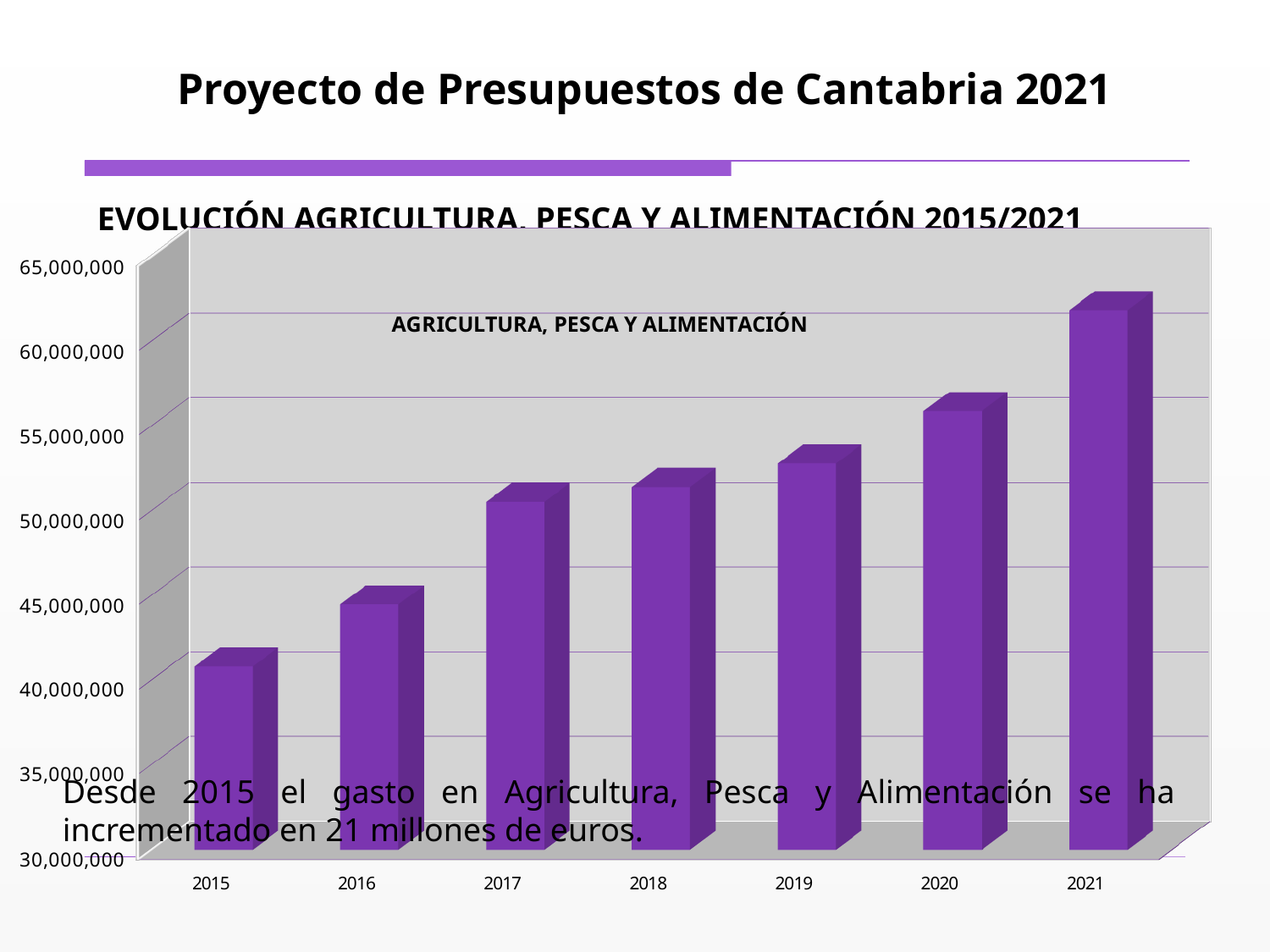
Is the value for 2019 greater or less than 50,000,000? greater Which is larger, the value for 2015 or the value for 2021? 2021 Which is larger, the value for 2016 or the value for 2019? 2019 What is the title of the chart? AGRICULTURA, PESCA Y ALIMENTACIÓN Do the values rise or fall from 2015 to 2021? rise Is the value for 2015 greater or less than 45,000,000? less Which year has the lowest value on the chart? 2015 Is the value for 2021 greater or less than 60,000,000? greater Which year has the highest value on the chart? 2021 How many years are plotted on the chart? 7 What kind of chart is shown on the slide? bar chart